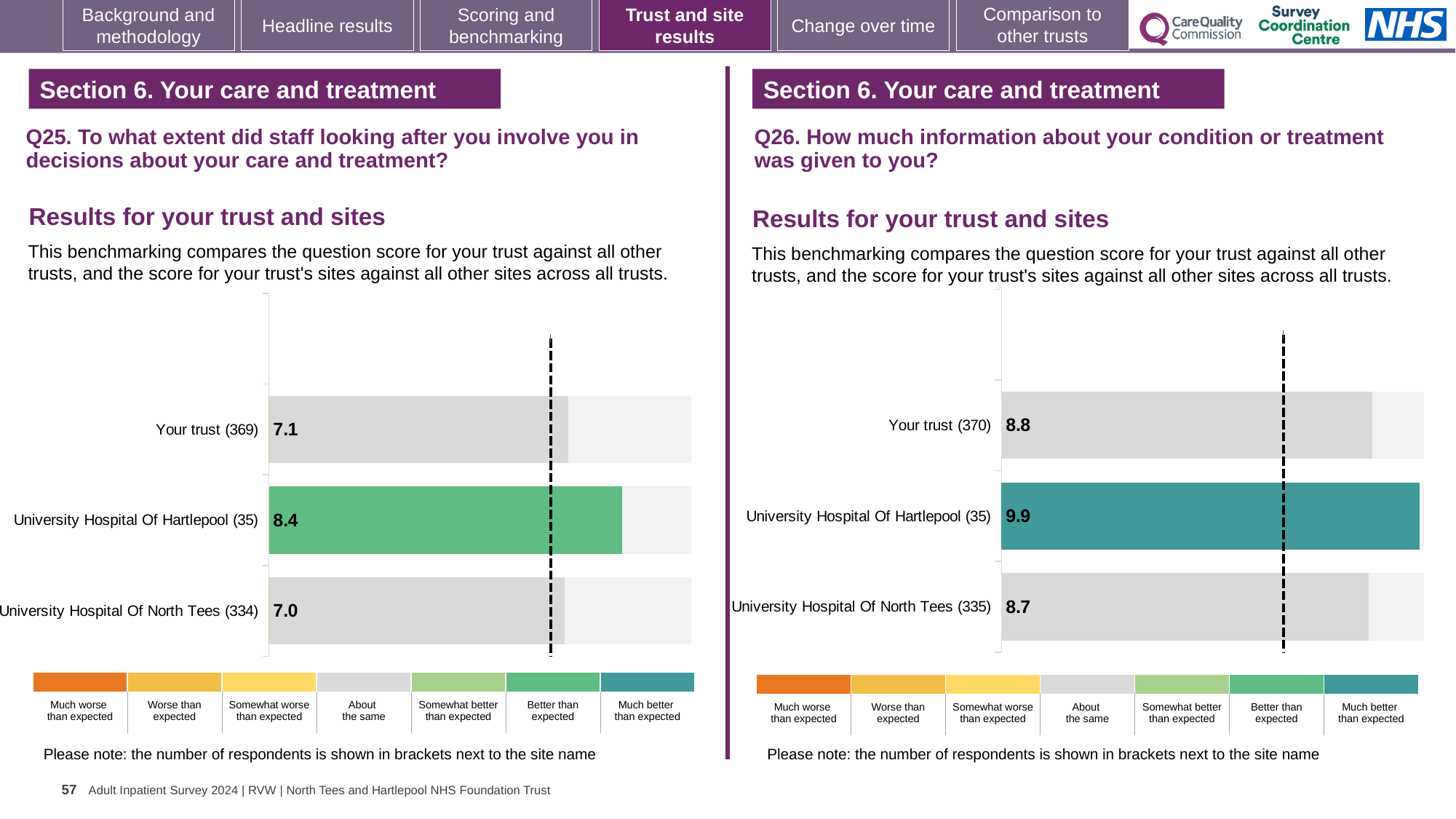
In the Q25 chart on the left, which site or trust has the lowest score? University Hospital Of North Tees (334) In the Q26 chart on the right, what is the score for University Hospital Of North Tees (335)? 8.7 In the Q26 chart on the right, which site or trust has the highest score? University Hospital Of Hartlepool (35) In the Q26 chart on the right, which has the larger score: Your trust or University Hospital Of North Tees? Your trust In the Q25 chart on the left, what is the score for University Hospital Of Hartlepool (35)? 8.4 In the Q26 chart on the right, what is the score for Your trust (370)? 8.8 What type of chart is used on the left for Q25? Bar chart In the Q25 chart on the left, what is the difference between the scores for University Hospital Of Hartlepool and University Hospital Of North Tees? 1.4 In the Q26 chart on the right, what is the difference between the scores for University Hospital Of Hartlepool and Your trust? 1.1 In the Q26 chart on the right, which benchmark category does the colour of the University Hospital Of Hartlepool bar correspond to in the legend? Much better than expected In the Q25 chart on the left, what is the score for Your trust (369)? 7.1 In the Q25 chart on the left, how many bars are plotted? 3